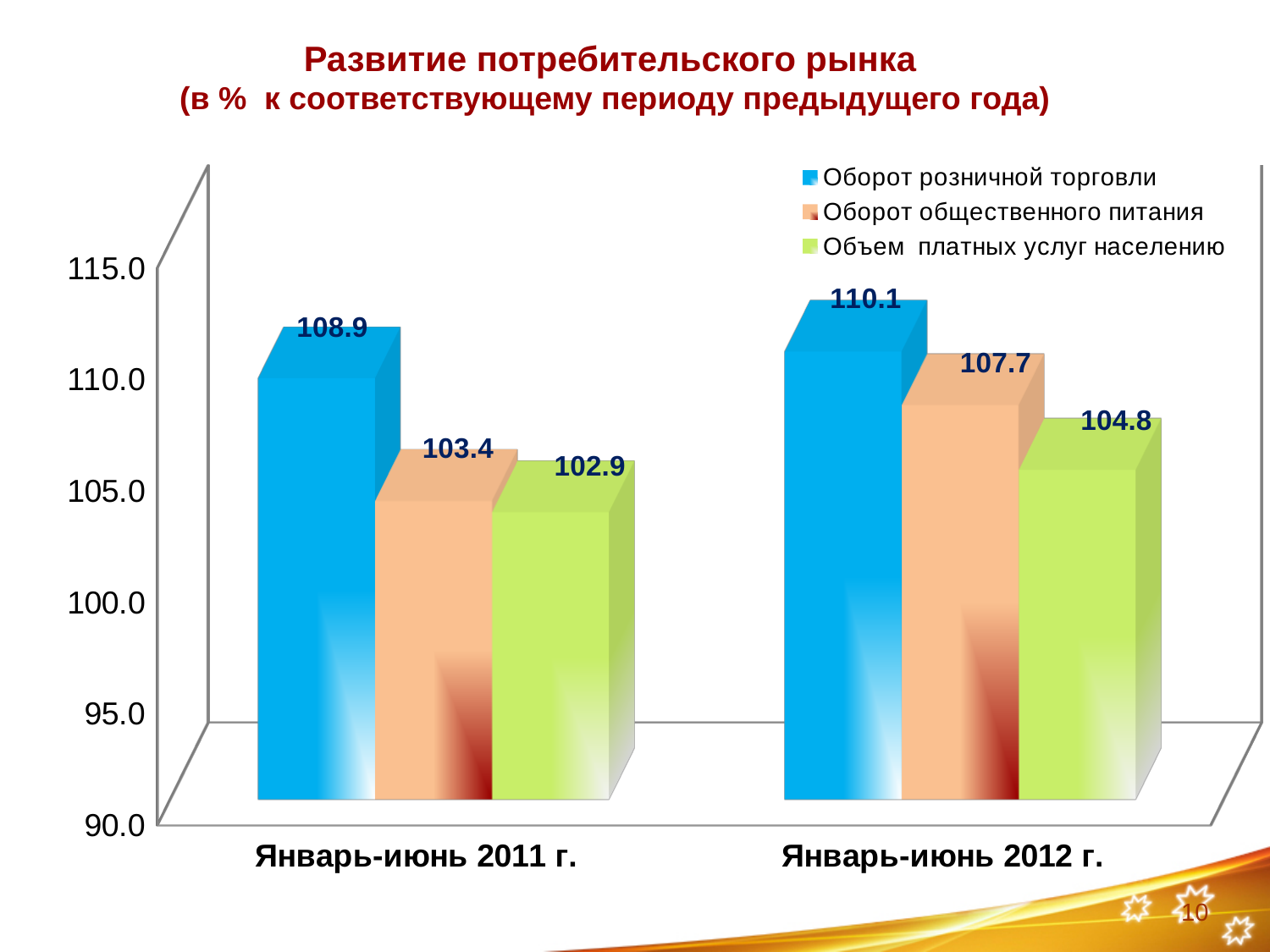
What is the difference between Оборот общественного питания in Январь-июнь 2012 г. and Январь-июнь 2011 г.? 4.3 Which is larger: Объем платных услуг населению for Январь-июнь 2012 г. or for Январь-июнь 2011 г.? Январь-июнь 2012 г. Which series has the highest value for Январь-июнь 2012 г.? Оборот розничной торговли What is the value of Оборот розничной торговли for Январь-июнь 2011 г.? 108.9 Which series has the lowest value for Январь-июнь 2011 г.? Объем платных услуг населению Does the value of Оборот розничной торговли rise or fall from Январь-июнь 2011 г. to Январь-июнь 2012 г.? rise What is the value of Оборот общественного питания for Январь-июнь 2012 г.? 107.7 What kind of chart is shown on the slide? bar chart Is the value of Оборот розничной торговли for Январь-июнь 2012 г. greater or less than 110.0? greater What is the value of Объем платных услуг населению for Январь-июнь 2011 г.? 102.9 How many series does the legend list? 3 How many categories are shown on the x axis? 2